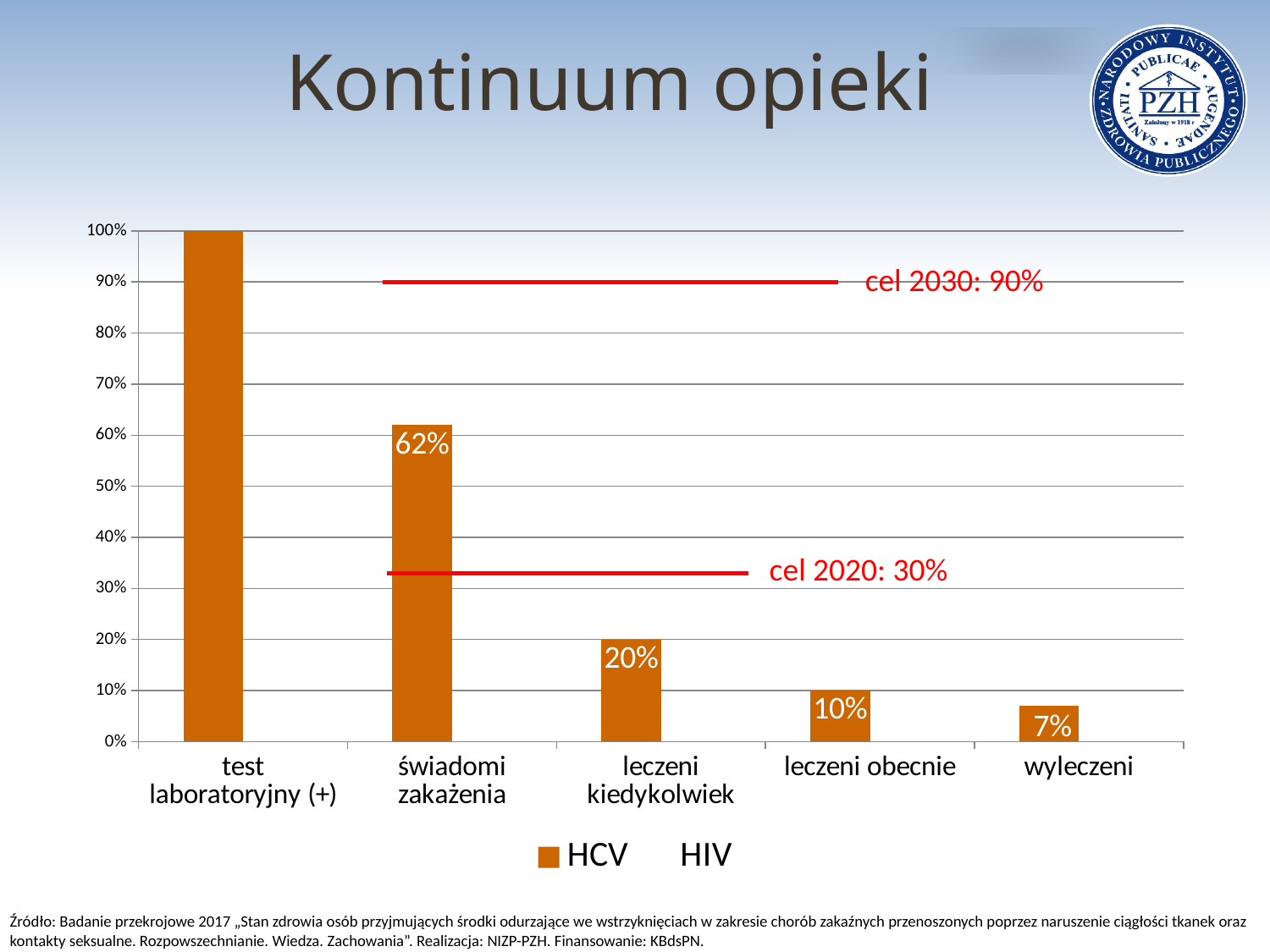
What is the value for świadomi zakażenia? 62% Which is larger, the value for leczeni obecnie or the value for wyleczeni? leczeni obecnie What is the value for leczeni kiedykolwiek? 20% What type of chart is shown on the slide? bar chart What target value is shown by the red line labelled 'cel 2020'? 30% How many categories are shown on the x axis? 5 What is the value for wyleczeni? 7% What is the value for leczeni obecnie? 10% Which category has the lowest value? wyleczeni Which category has the highest value? test laboratoryjny (+) What is the difference between the values for świadomi zakażenia and leczeni kiedykolwiek? 42% What is the value for test laboratoryjny (+)? 100%